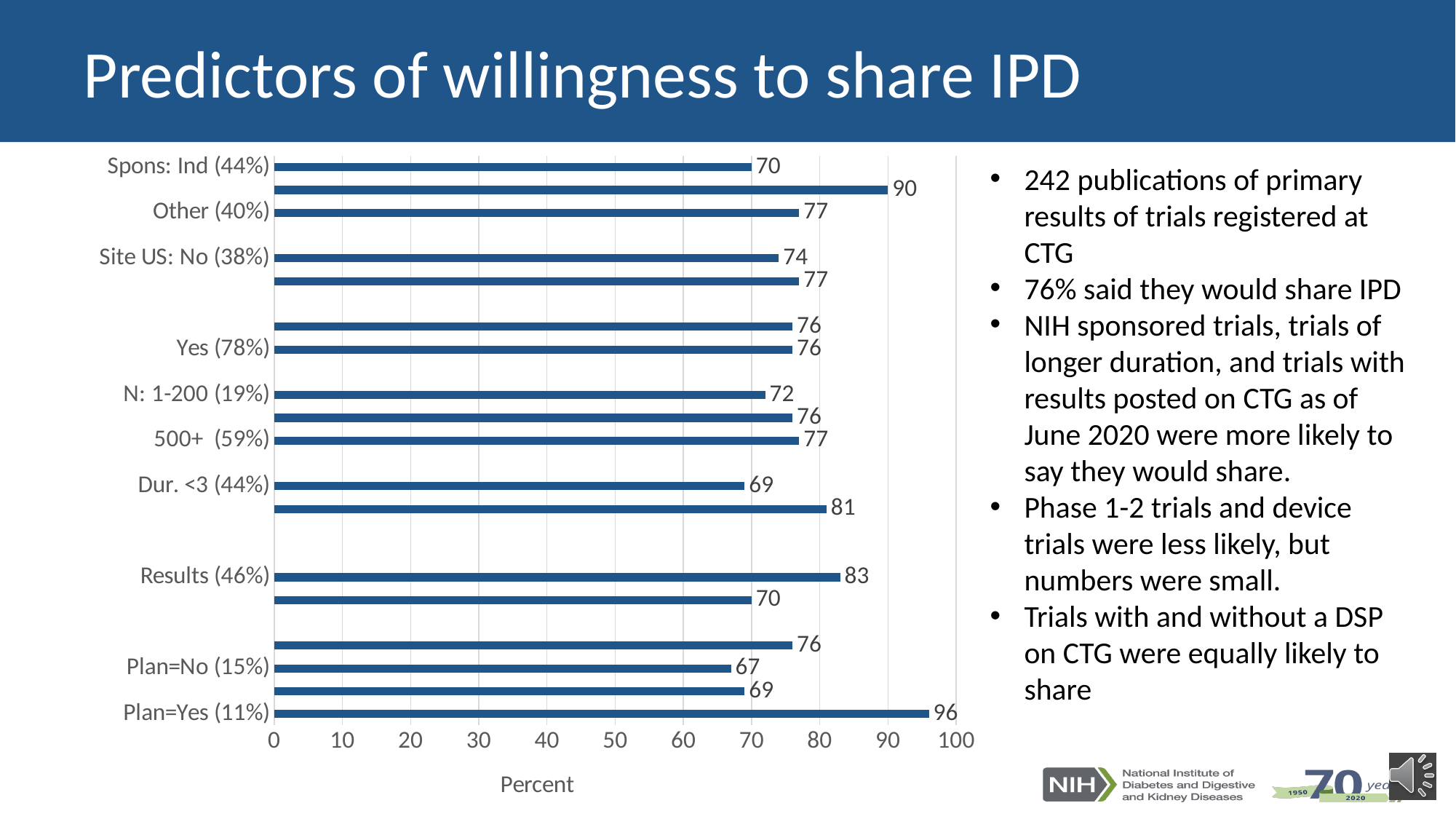
What is the value for Site US: No (38%)? 74 What is the value for N: 1-200 (19%)? 72 What kind of chart is shown on the slide? Bar chart Which is larger, the value for Results (46%) or the value for Dur. <3 (44%)? Results (46%) What is the value for Plan=Yes (11%)? 96 Which labeled category has the lowest value? Plan=No (15%) What is the value for Spons: Ind (44%)? 70 How many bars are plotted in the chart? 18 What is the difference between the values for Plan=Yes (11%) and Plan=No (15%)? 29 Which labeled category has the highest value? Plan=Yes (11%) What is the title of the horizontal axis? Percent What is the value for Results (46%)? 83